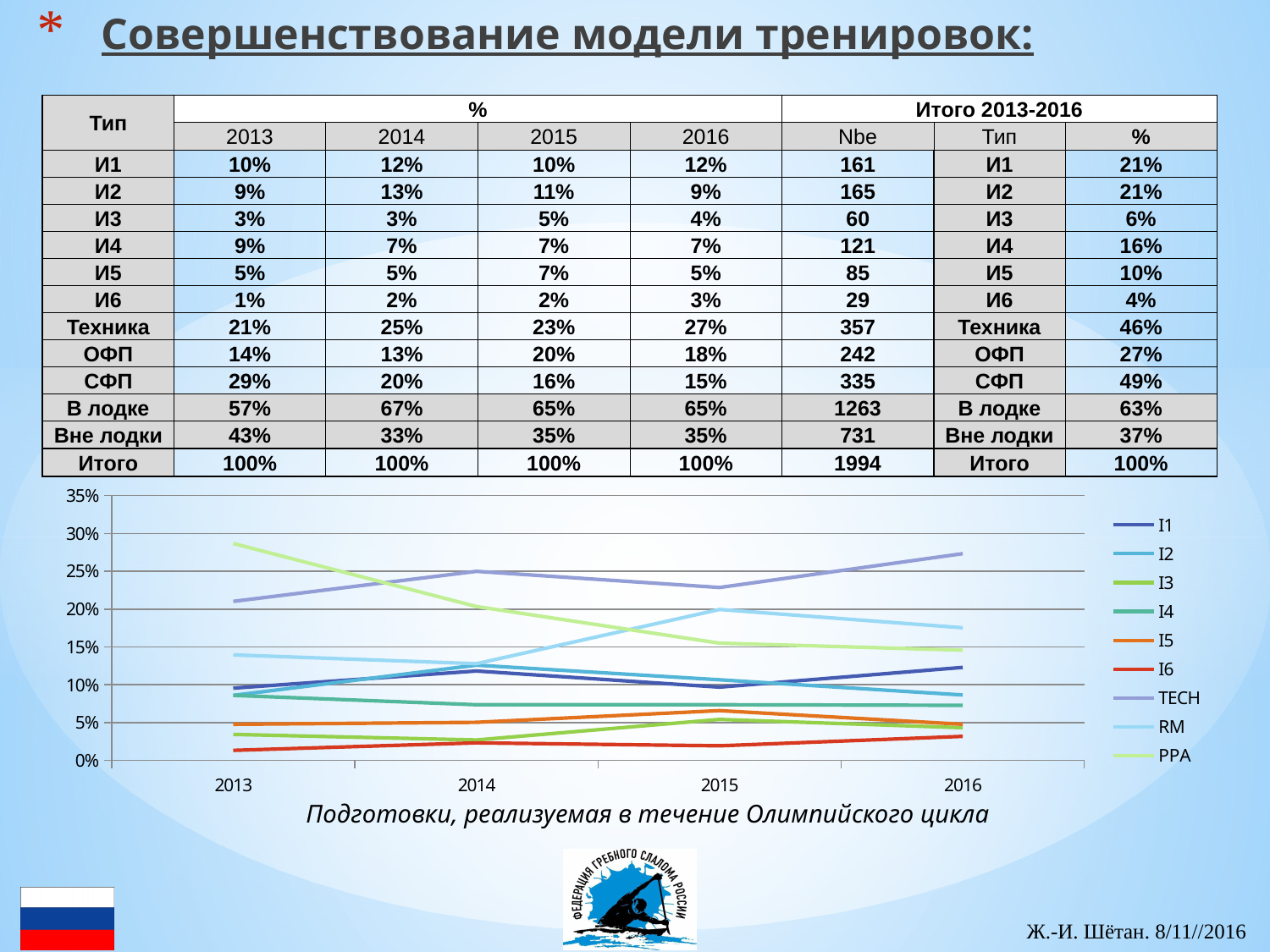
Which series has the lowest value in 2013 on the chart? I6 Which series has the highest value in 2016 on the chart? TECH How many years are plotted along the x axis of the chart? 4 Is the value for TECH in 2016 greater or less than 25%? greater Is the value for I6 in 2016 greater or less than 5%? less Is the value for PPA in 2013 greater or less than 25%? greater What kind of chart is shown below the table? line chart How many series does the chart's legend list? 9 Which series has the highest value in 2013 on the chart? PPA What are the first and last years shown on the chart's x axis? 2013 and 2016 Does the PPA series rise or fall from 2013 to 2016? fall In 2015, which is larger on the chart: RM or PPA? RM